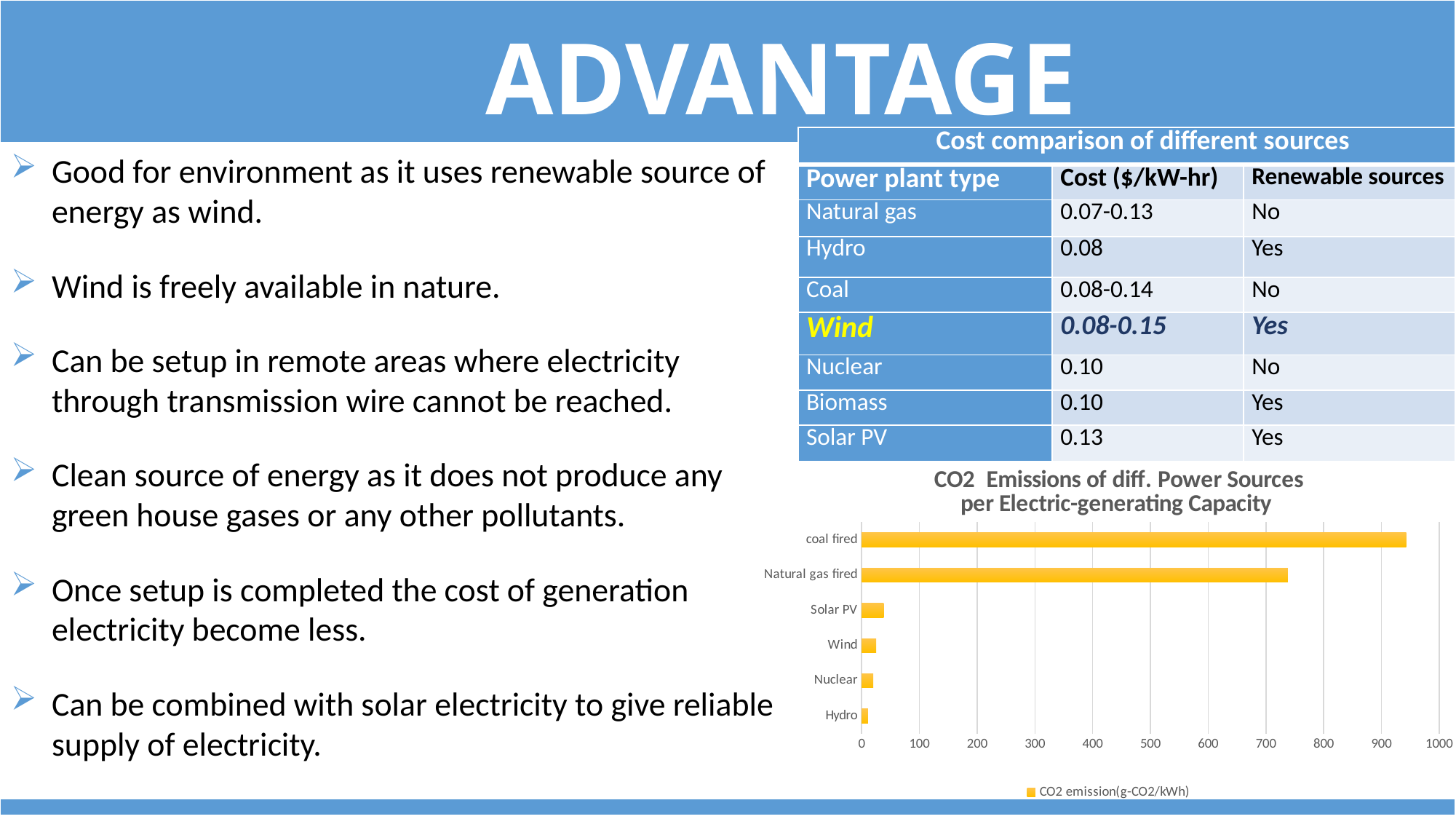
Which power source has the lowest CO2 emission in the chart? Hydro Is the CO2 emission value for coal fired greater or less than 900? greater Which has a higher CO2 emission, Natural gas fired or Solar PV? Natural gas fired What kind of chart is shown on the slide? bar chart Which power source has the highest CO2 emission in the chart? coal fired How many series does the legend of the CO2 emissions chart list? 1 Is the CO2 emission value for Natural gas fired greater or less than 700? greater What is the legend entry of the CO2 emissions chart? CO2 emission(g-CO2/kWh) Is the CO2 emission value for Solar PV greater or less than 100? less What is the title of the chart on the slide? CO2 Emissions of diff. Power Sources per Electric-generating Capacity Which has a higher CO2 emission, coal fired or Natural gas fired? coal fired How many power sources are plotted in the CO2 emissions chart? 6